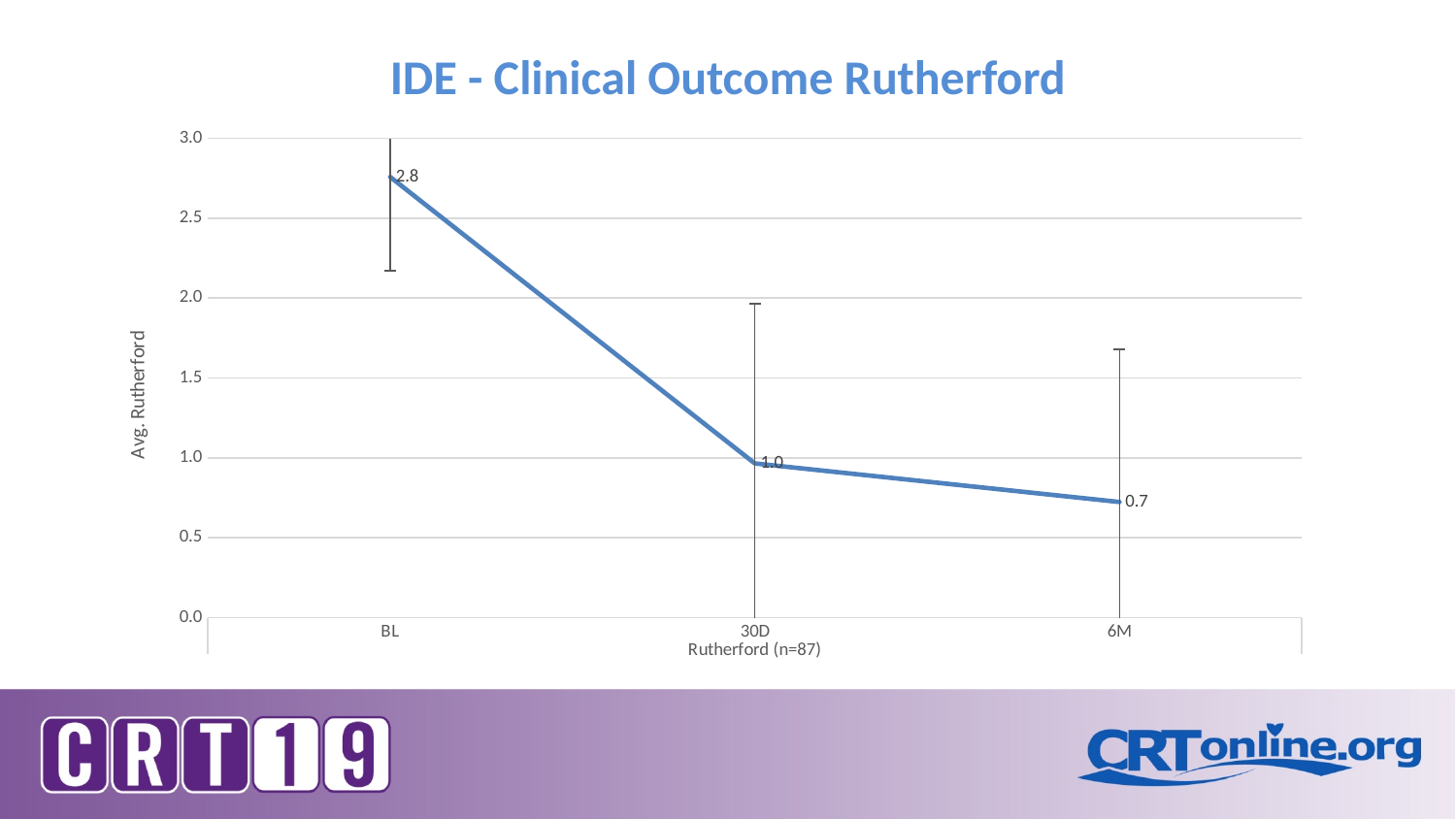
What is the average Rutherford value at 6M? 0.7 What is the difference between the average Rutherford value at 30D and at 6M? 0.3 What is the average Rutherford value at 30D? 1.0 What is the average Rutherford value at BL? 2.8 Which time point has the lowest average Rutherford value? 6M Do the average Rutherford values rise or fall from BL to 6M? fall What kind of chart is shown on the slide? line chart Which time point has the highest average Rutherford value? BL Which is larger, the average Rutherford value at BL or at 6M? BL How many time points are plotted on the chart? 3 What is the difference between the average Rutherford value at BL and at 30D? 1.8 Is the average Rutherford value at BL greater or less than 2.5? greater